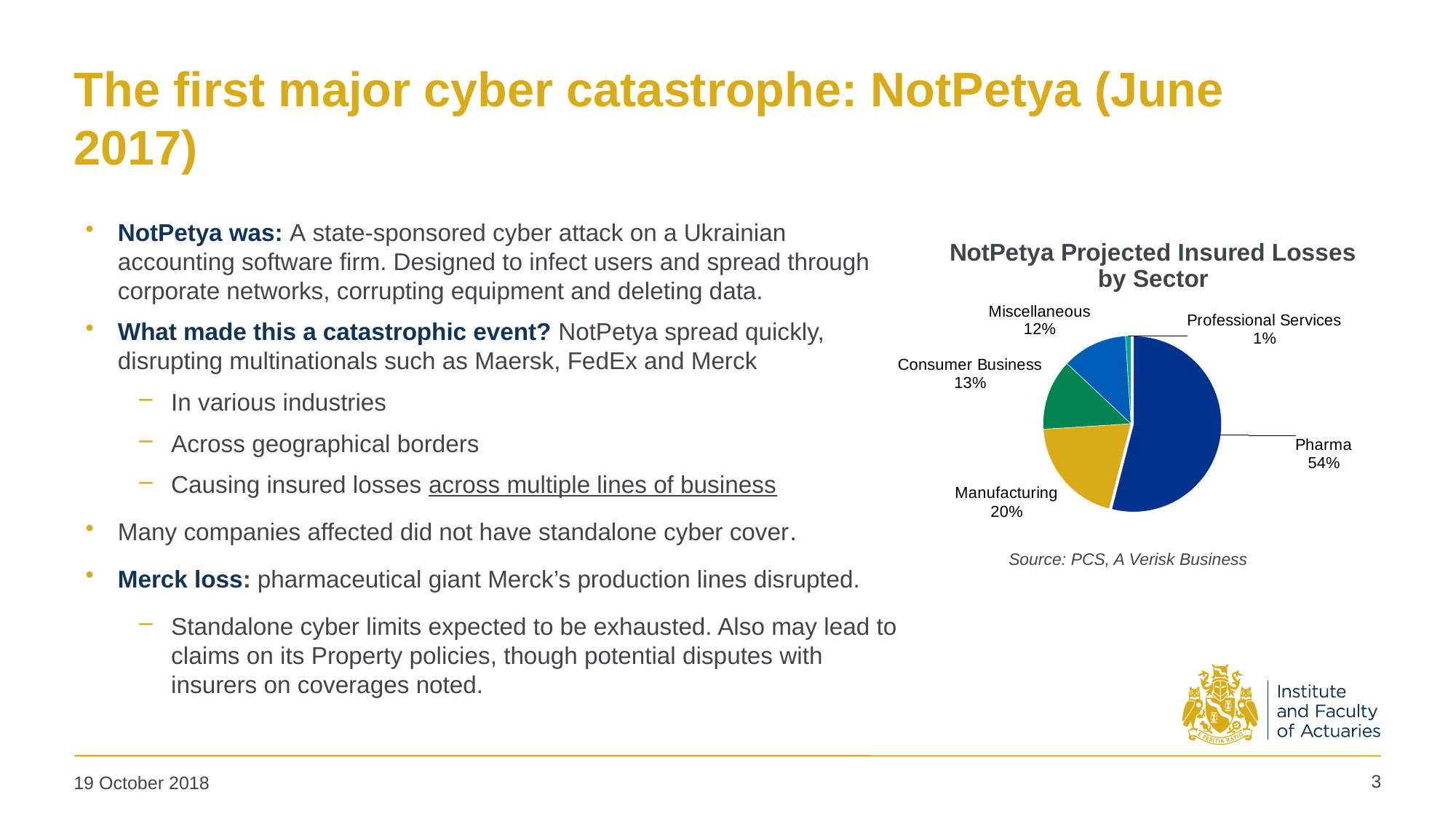
Which sector has the largest share of NotPetya projected insured losses? Pharma What is the title of the chart on the slide? NotPetya Projected Insured Losses by Sector What type of chart is used to show NotPetya projected insured losses by sector? Pie chart What share of NotPetya projected insured losses is attributed to Miscellaneous? 12% What share of NotPetya projected insured losses is attributed to Pharma? 54% What share of NotPetya projected insured losses is attributed to Manufacturing? 20% What is the difference in share between Pharma and Manufacturing in the NotPetya projected insured losses chart? 34% What share of NotPetya projected insured losses is attributed to Consumer Business? 13% How many sectors are shown in the NotPetya projected insured losses pie chart? 5 Which sector has a larger share of NotPetya projected insured losses, Consumer Business or Miscellaneous? Consumer Business Which sector has the smallest share of NotPetya projected insured losses? Professional Services What share of NotPetya projected insured losses is attributed to Professional Services? 1%